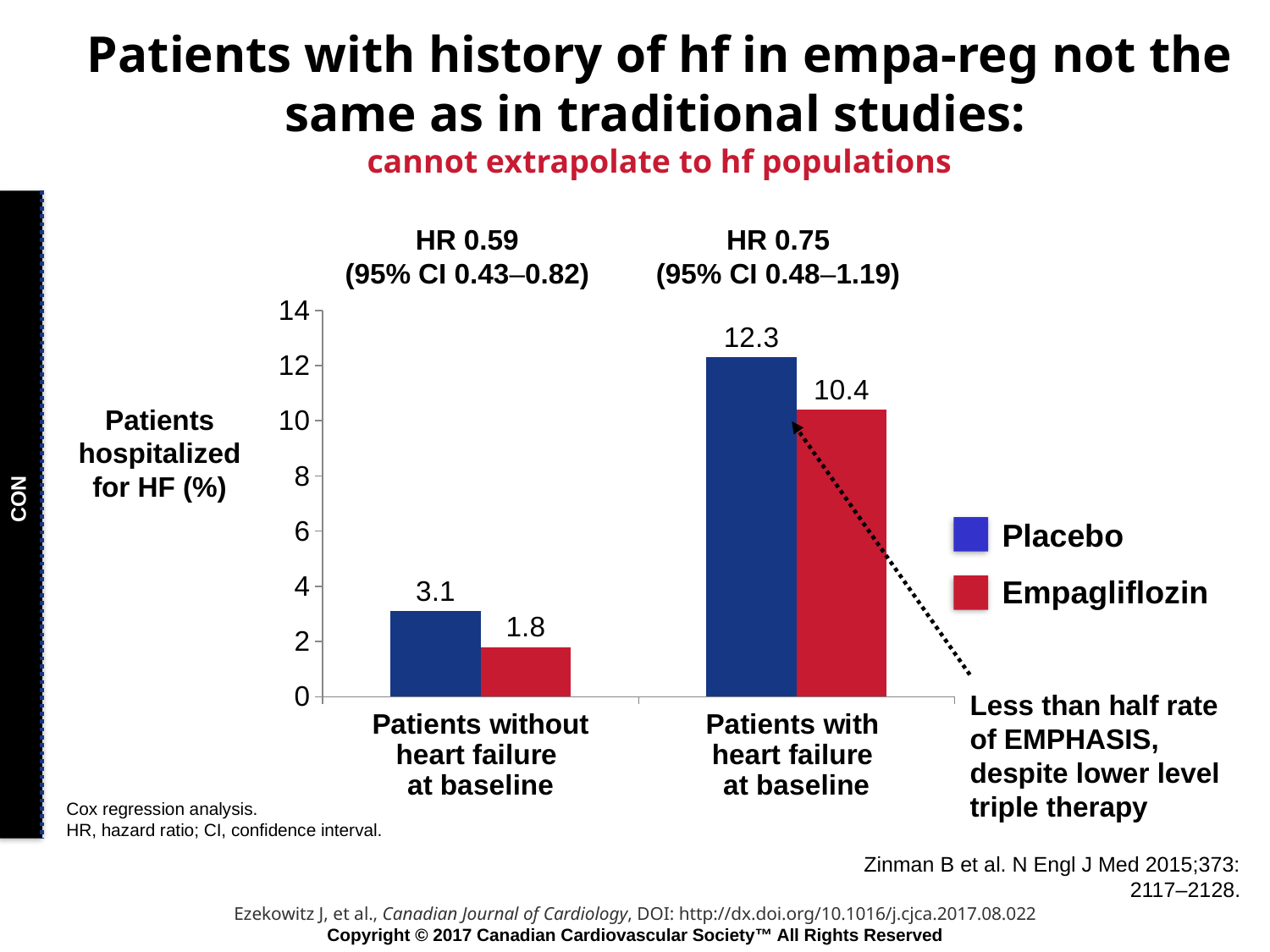
Which bar has the highest value on the chart? Placebo, patients with heart failure at baseline What is the value for Empagliflozin among patients without heart failure at baseline? 1.8 Which is larger: the Placebo value for patients with heart failure at baseline or the Placebo value for patients without heart failure at baseline? Patients with heart failure at baseline What is the difference between the Placebo and Empagliflozin values for patients without heart failure at baseline? 1.3 What is the value for Placebo among patients without heart failure at baseline? 3.1 What is the value for Empagliflozin among patients with heart failure at baseline? 10.4 How many series does the legend list? 2 What kind of chart is shown on the slide? Bar chart What is the value for Placebo among patients with heart failure at baseline? 12.3 What is the difference between the Placebo and Empagliflozin values for patients with heart failure at baseline? 1.9 How many categories are shown on the x axis? 2 Which bar has the lowest value on the chart? Empagliflozin, patients without heart failure at baseline